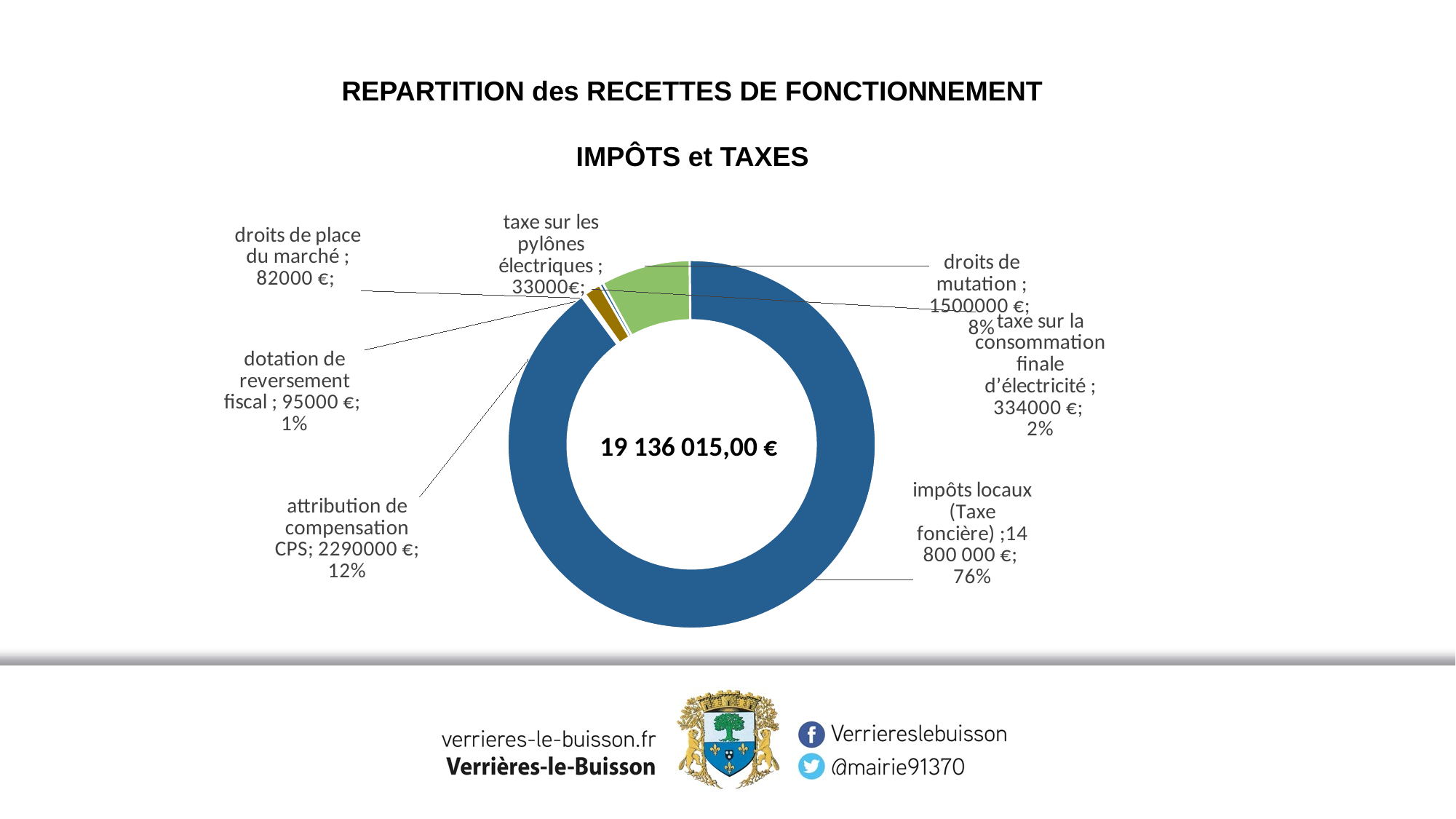
What share of the chart does taxe sur la consommation finale d'électricité represent? 2% What is the difference between droits de mutation and taxe sur la consommation finale d'électricité? 1166000 € What is the value shown for impôts locaux (Taxe foncière)? 14 800 000 € Which category has the largest value? impôts locaux (Taxe foncière) Which is larger, dotation de reversement fiscal or droits de place du marché? dotation de reversement fiscal What total amount is displayed in the centre of the chart? 19 136 015,00 € What is the value shown for attribution de compensation CPS? 2290000 € What is the value shown for taxe sur les pylônes électriques? 33000€ How many categories are shown in the chart? 7 Which category has the smallest value? taxe sur les pylônes électriques What is the value shown for droits de mutation? 1500000 € What share of the chart does attribution de compensation CPS represent? 12%